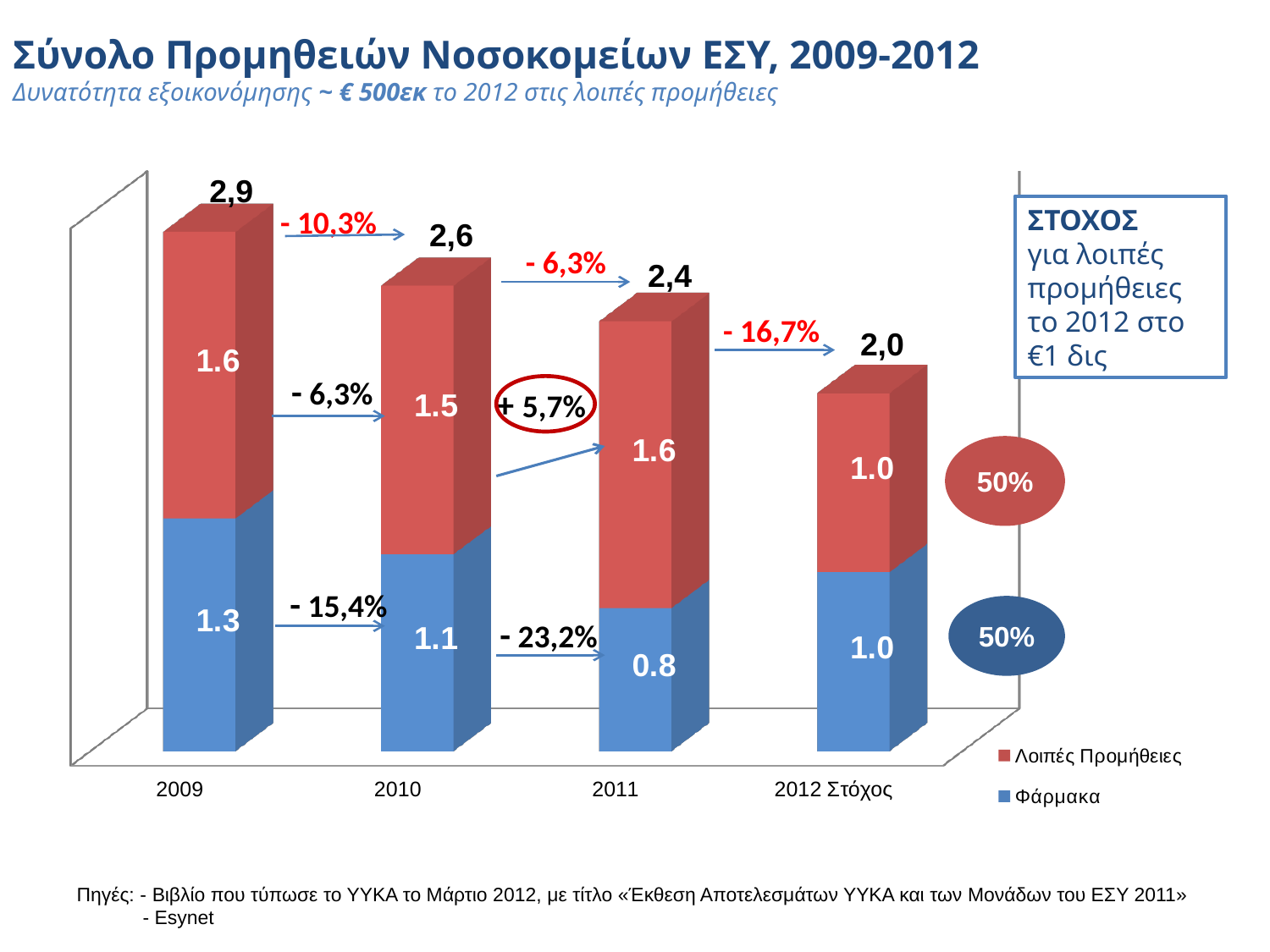
How many categories are shown on the x axis? 4 Which is larger for 2010: Λοιπές Προμήθειες or Φάρμακα? Λοιπές Προμήθειες What kind of chart is shown on the slide? Stacked bar chart What is the total of the stacked bar for 2010? 2,6 Which category has the highest total? 2009 How many series does the legend list? 2 What is the difference between the Φάρμακα values for 2009 and 2011? 0.5 What is the value of Φάρμακα for 2009? 1.3 Do the bar totals rise or fall from 2009 to 2012 Στόχος? Fall What is the value of Λοιπές Προμήθειες for 2011? 1.6 What is the total of the stacked bar for 2012 Στόχος? 2,0 Which category has the lowest value for Φάρμακα? 2011